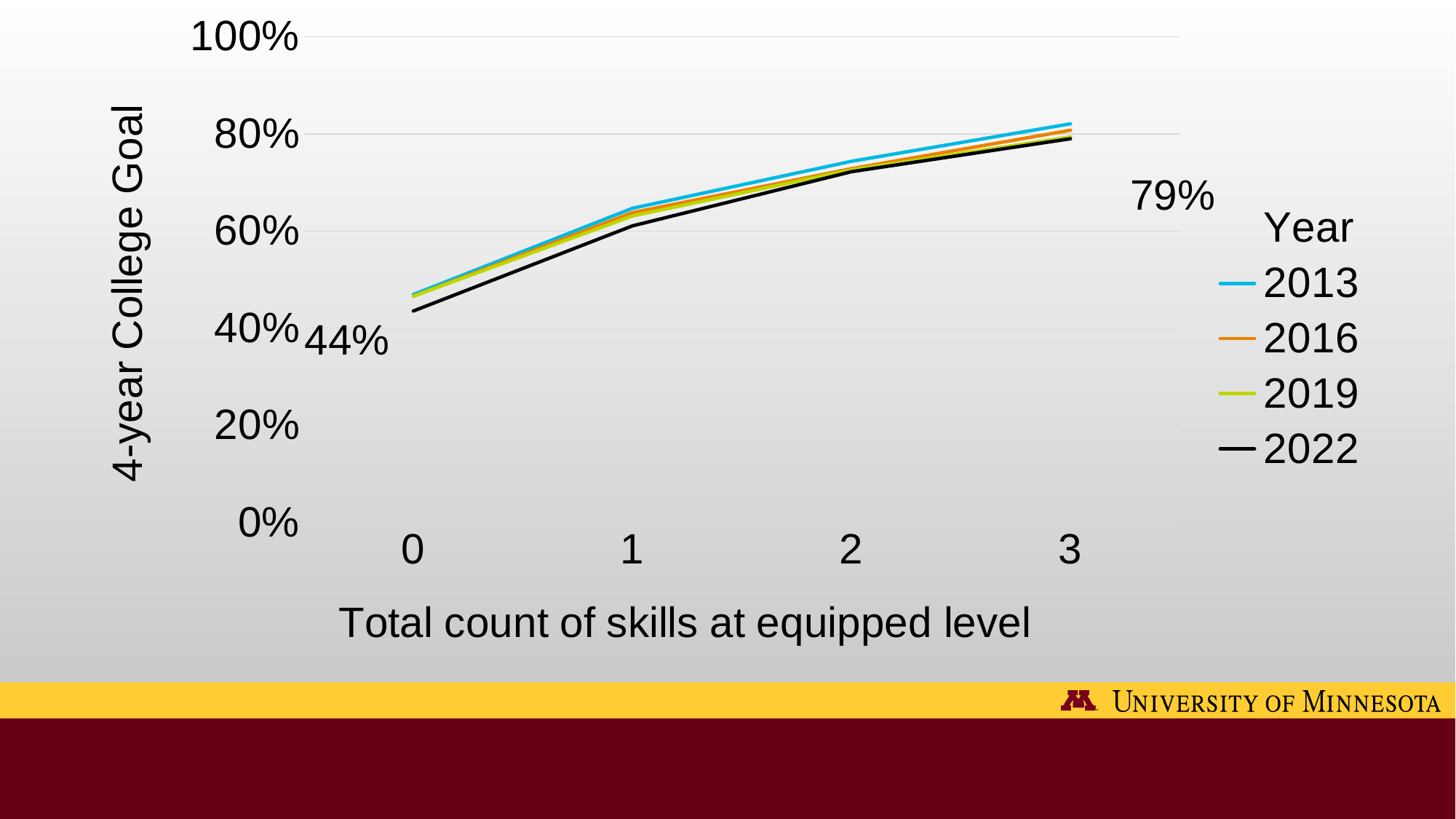
What kind of chart is shown on the slide? line chart What is the difference between the 2022 values at 3 skills and at 0 skills at equipped level? 35 percentage points Do the values rise or fall as the total count of skills at equipped level increases? rise Which series has the highest value at 3 skills at equipped level? 2013 How many points are on the x axis (total count of skills at equipped level)? 4 How many series does the legend list? 4 What is the labelled value for the 2022 series at 0 skills at equipped level? 44% Is the value for the 2013 series at 2 skills at equipped level greater or less than 60%? greater What is the title of the y axis? 4-year College Goal What is the labelled value for the 2022 series at 3 skills at equipped level? 79% Which series has the lowest value at 0 skills at equipped level? 2022 Is the value for the 2022 series at 2 skills at equipped level greater or less than 80%? less